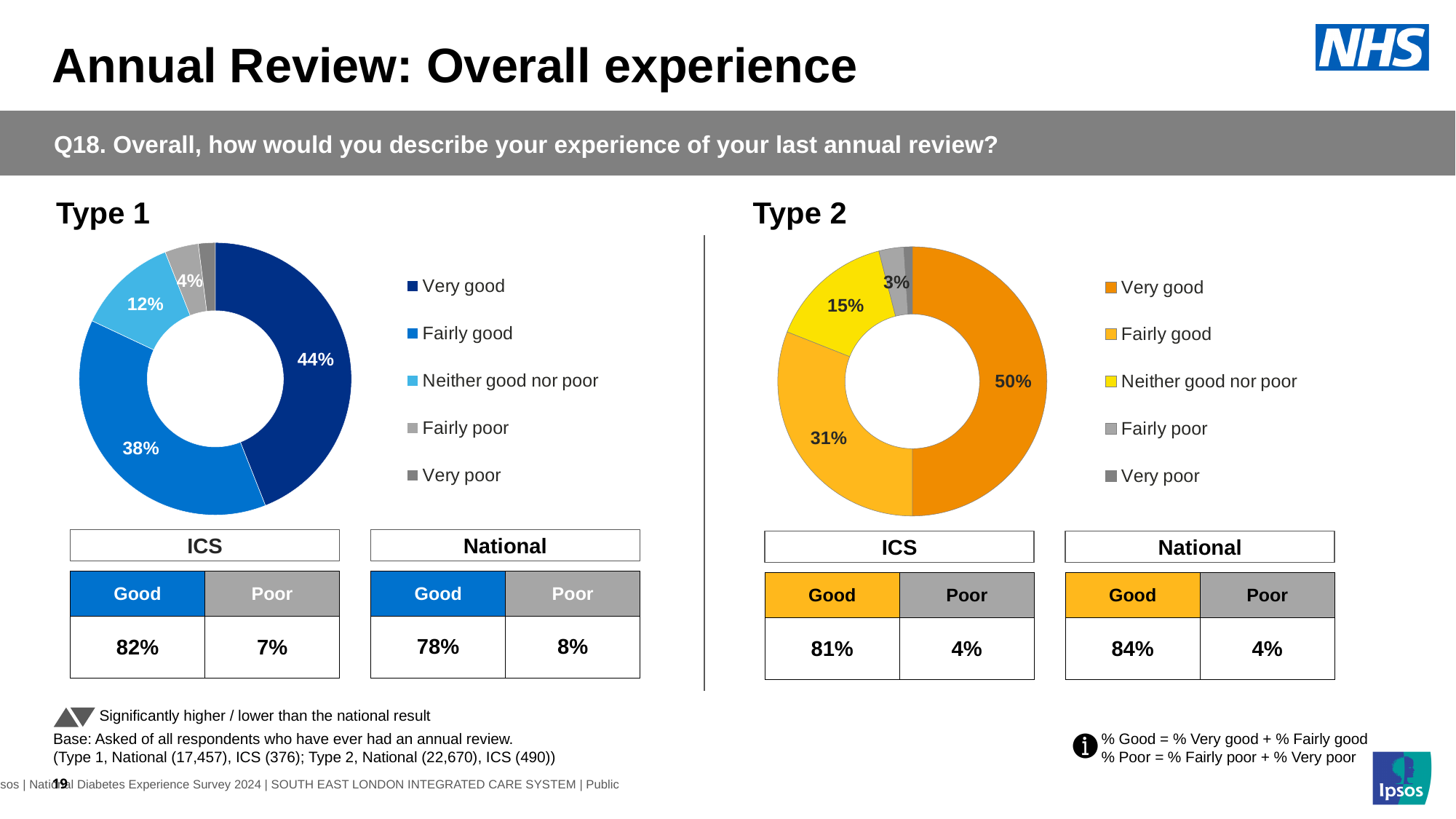
How many entries does the legend of the Type 1 chart list? 5 In the Type 2 chart, which is larger: the Fairly good share or the Neither good nor poor share? Fairly good In the Type 1 chart, what percentage of respondents said Neither good nor poor? 12% In the Type 2 chart, which response category has the largest share? Very good In the Type 1 chart, what percentage of respondents said their experience was Very good? 44% In the Type 2 chart, what percentage of respondents said Neither good nor poor? 15% In the Type 2 chart, what percentage of respondents said their experience was Very good? 50% In the Type 1 chart, which response category has the largest share? Very good In the Type 1 chart, what percentage of respondents said their experience was Fairly good? 38% In the Type 1 chart, what is the difference between the Very good and Fairly good shares? 6 percentage points What kind of chart is used for Type 1 and Type 2? Pie (donut) chart In the Type 2 chart, what percentage of respondents said Fairly poor? 3%